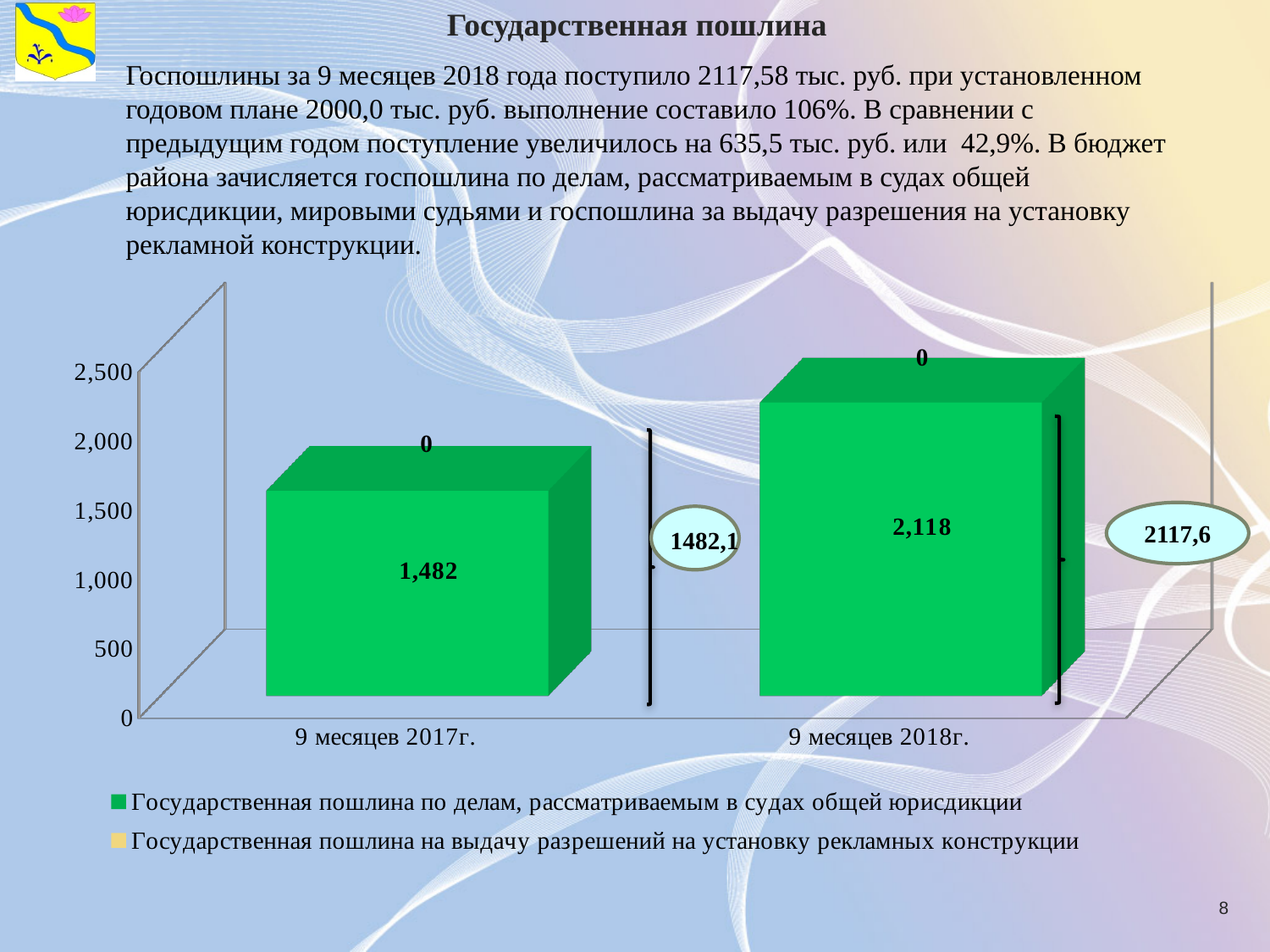
How many series does the chart legend list? 2 Is the green series value for 9 месяцев 2017г. greater or less than 2,000? less What is the difference between the green series values for 9 месяцев 2018г. and 9 месяцев 2017г.? 636 What is the value of the green series (госпошлина по делам, рассматриваемым в судах общей юрисдикции) for 9 месяцев 2017г.? 1,482 What is the total of the stacked bar for 9 месяцев 2017г.? 1,482 What is the value of the green series (госпошлина по делам, рассматриваемым в судах общей юрисдикции) for 9 месяцев 2018г.? 2,118 Which category has the higher value for the green series? 9 месяцев 2018г. What value is labelled for the series 'Государственная пошлина на выдачу разрешений на установку рекламных конструкции' for 9 месяцев 2018г.? 0 Do the green series values rise or fall from 9 месяцев 2017г. to 9 месяцев 2018г.? rise Which category has the lower value for the green series? 9 месяцев 2017г. What kind of chart is shown on the slide? bar chart How many categories are shown on the x axis of the chart? 2